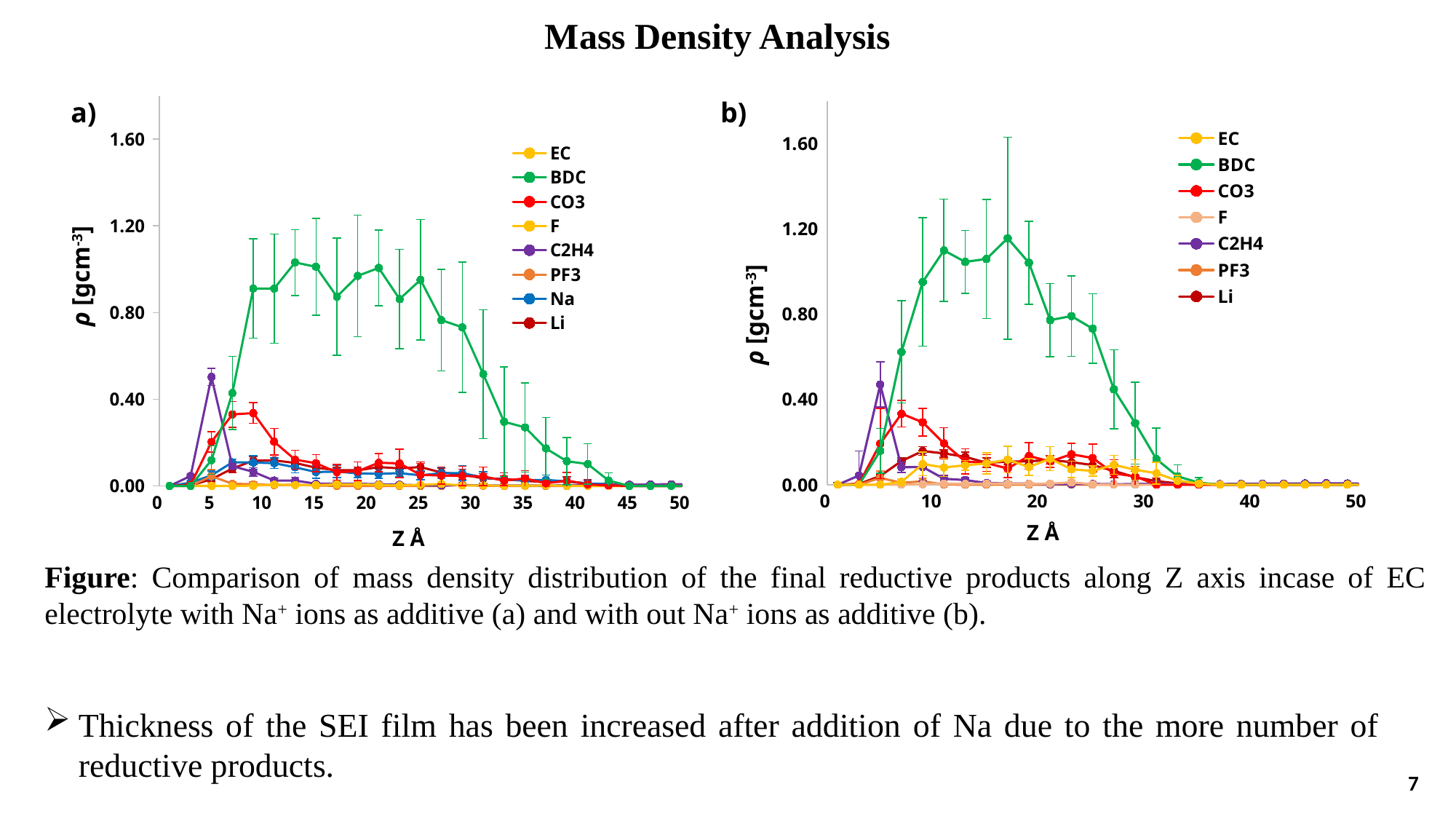
In chart a), does the BDC series rise or fall between Z = 30 and Z = 45? fall How many series does the legend of chart a) list? 8 How many series does the legend of chart b) list? 7 In chart a), is the value for BDC at Z = 15 greater or less than 0.80? greater Which series appears in the legend of chart a) but not in the legend of chart b)? Na In chart b), is the value for BDC at Z = 17 greater or less than 0.80? greater In chart a), is the value for CO3 at Z = 9 greater or less than 0.40? less In chart a), which series reaches the highest density? BDC In chart b), which series reaches the highest density? BDC What kind of chart is chart a)? line chart